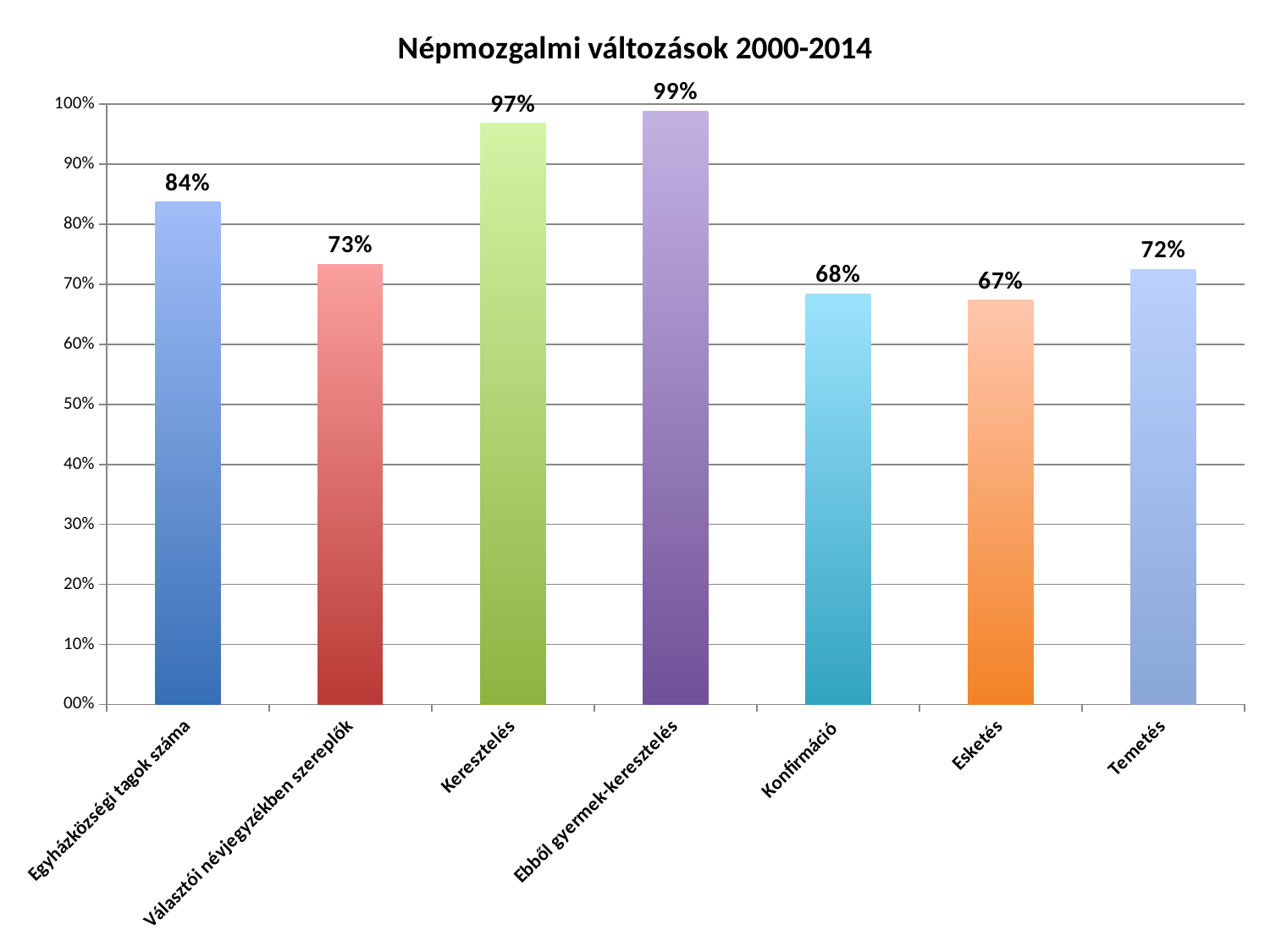
What is the difference between the values for Ebből gyermek-keresztelés and Esketés? 32% What is the value for Keresztelés? 97% Is the value for Konfirmáció greater or less than 70%? less What is the value for Egyházközségi tagok száma? 84% Which category has the lowest value? Esketés How many categories are shown in the chart? 7 What kind of chart is shown on the slide? bar chart Which is larger, the value for Egyházközségi tagok száma or the value for Választói névjegyzékben szereplők? Egyházközségi tagok száma What is the difference between the values for Keresztelés and Konfirmáció? 29% What is the value for Temetés? 72% What is the title of the chart? Népmozgalmi változások 2000-2014 Which category has the highest value? Ebből gyermek-keresztelés